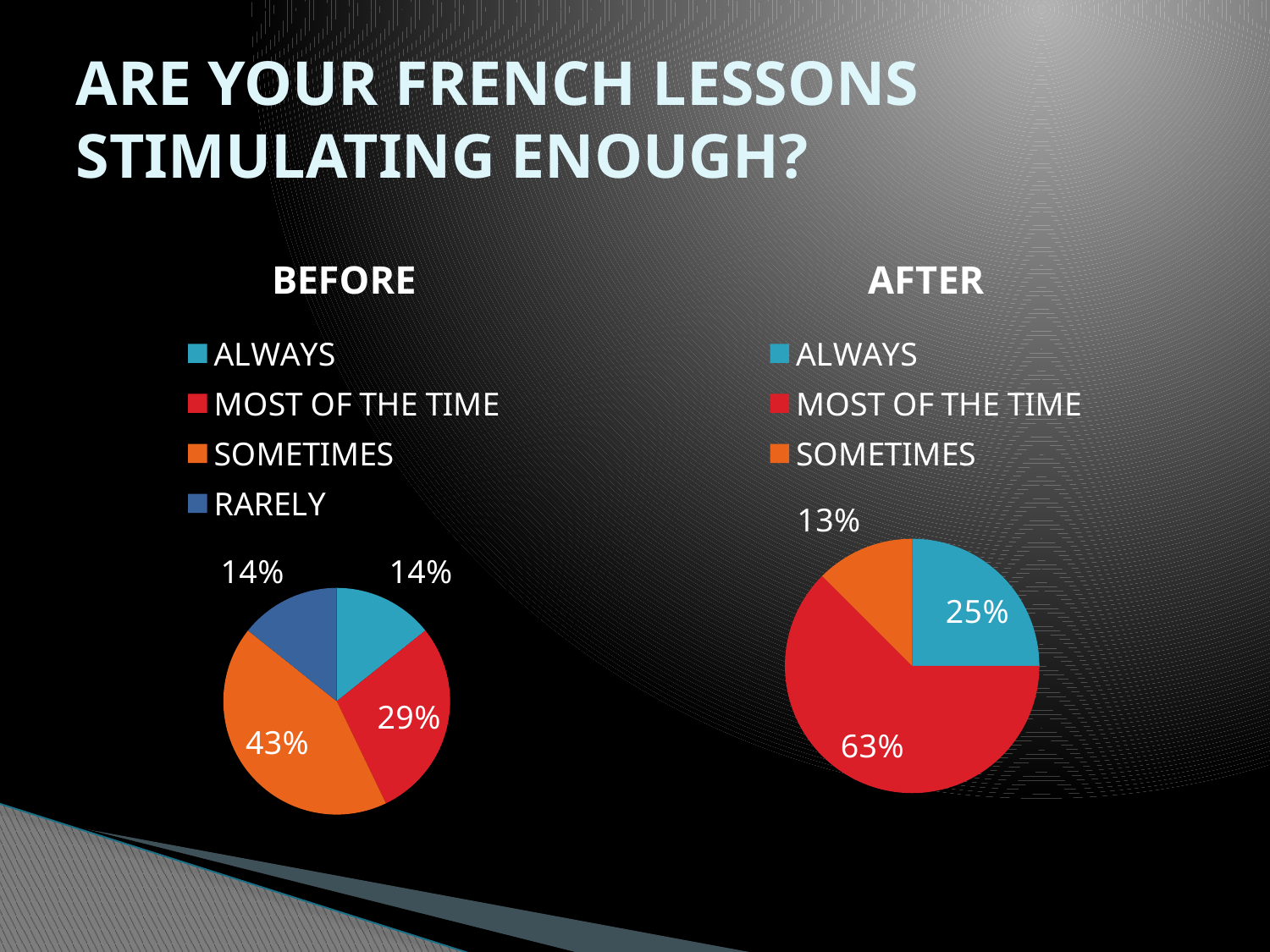
In the AFTER chart, what percentage is shown for ALWAYS? 25% In the BEFORE chart, which category has the largest share? SOMETIMES How many categories does the legend of the BEFORE chart list? 4 How many categories does the legend of the AFTER chart list? 3 In the BEFORE chart, what colour is the RARELY slice? Blue In the BEFORE chart, what percentage is shown for SOMETIMES? 43% In the BEFORE chart, what percentage is shown for MOST OF THE TIME? 29% In the AFTER chart, which category has the smallest share? SOMETIMES In the AFTER chart, what is the difference in percentage points between MOST OF THE TIME and ALWAYS? 38 In the AFTER chart, what percentage is shown for MOST OF THE TIME? 63% In the BEFORE chart, which is larger: SOMETIMES or MOST OF THE TIME? SOMETIMES What type of chart is the AFTER chart? Pie chart